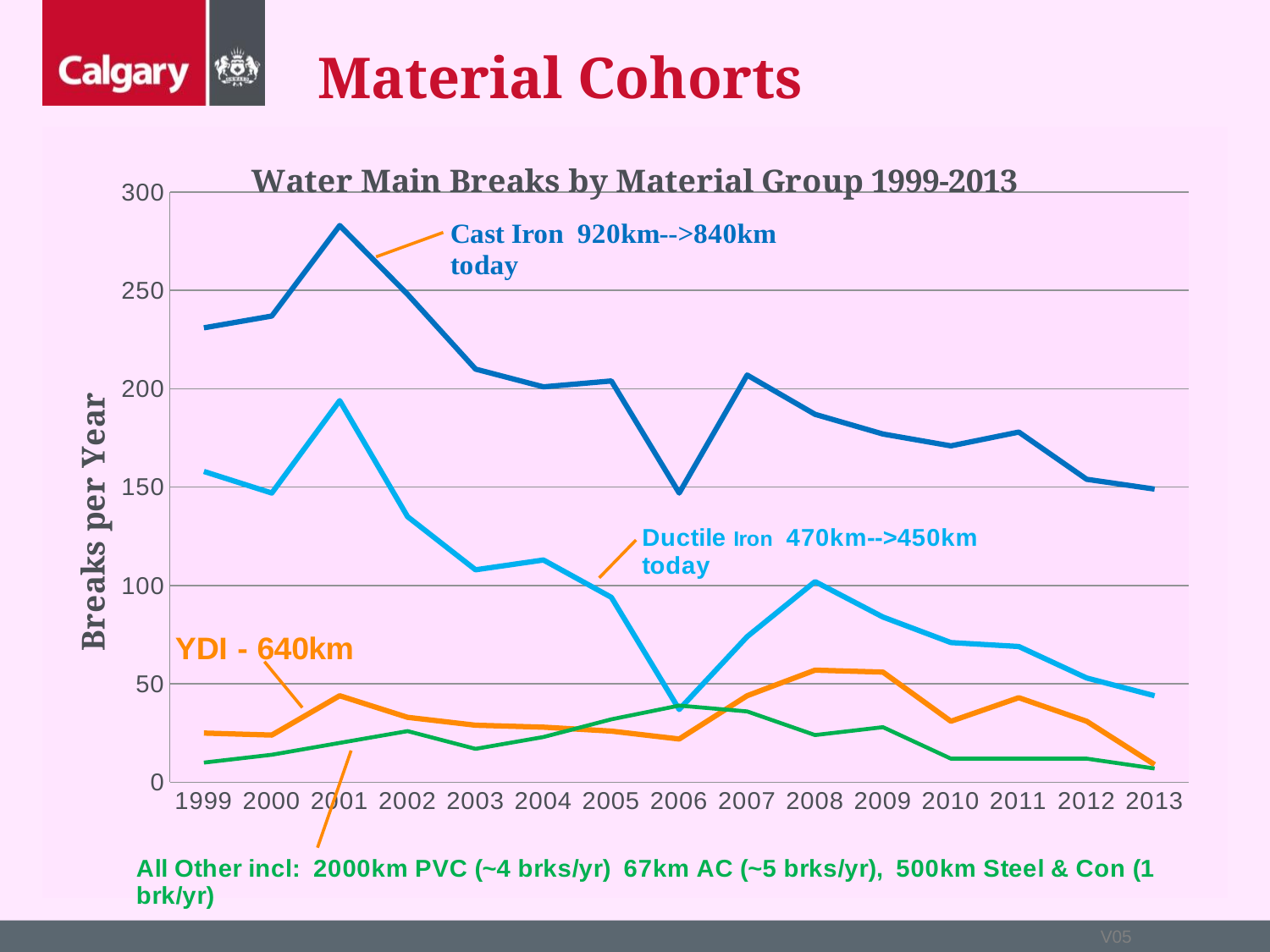
In which year does the Ductile Iron line reach its highest value? 2001 What is the title of the chart? Water Main Breaks by Material Group 1999-2013 Is the Cast Iron value for 2001 greater or less than 250? greater How many years are plotted along the x axis of the chart? 15 What kind of chart is shown on the slide? line chart Overall, does the Cast Iron line rise or fall from 1999 to 2013? fall Is the Cast Iron value for 1999 greater or less than 250? less In 2008, which has more breaks per year, Cast Iron or Ductile Iron? Cast Iron What is the label on the vertical axis of the chart? Breaks per Year Is the Ductile Iron value for 2006 greater or less than 50? less In which year does the Cast Iron line reach its highest value? 2001 How many material series are plotted on the chart? 4